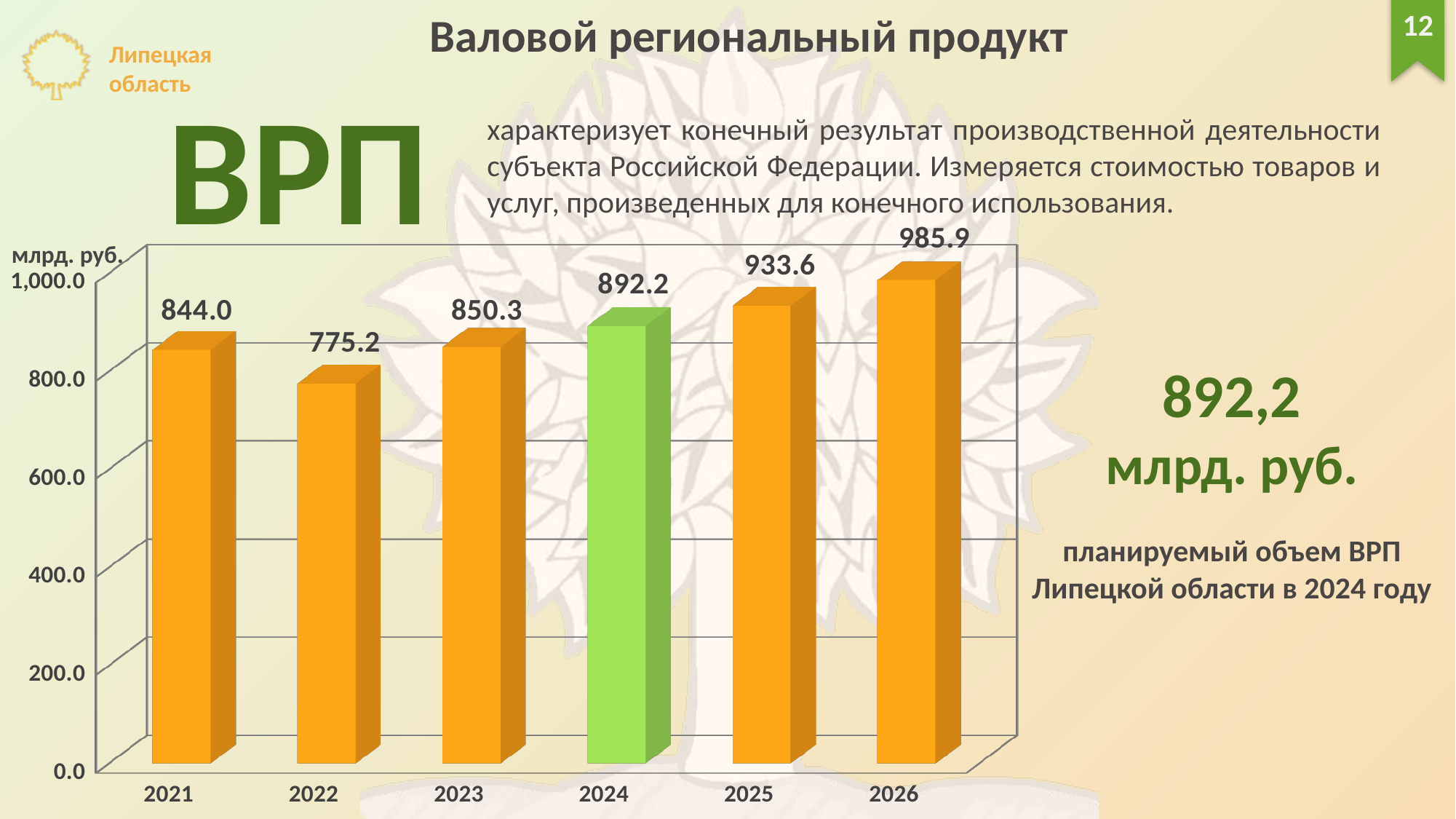
How many years are shown on the x axis? 6 What is the value for 2021? 844.0 Which is larger, the value for 2023 or the value for 2021? 2023 What is the value for 2026? 985.9 Which bar is coloured green rather than orange? 2024 What is the value for 2024? 892.2 Which year has the highest value? 2026 What is the difference between the values for 2021 and 2022? 68.8 Is the value for 2025 greater or less than 800.0? greater What kind of chart is shown on the slide? bar chart Which year has the lowest value? 2022 What is the difference between the values for 2026 and 2025? 52.3